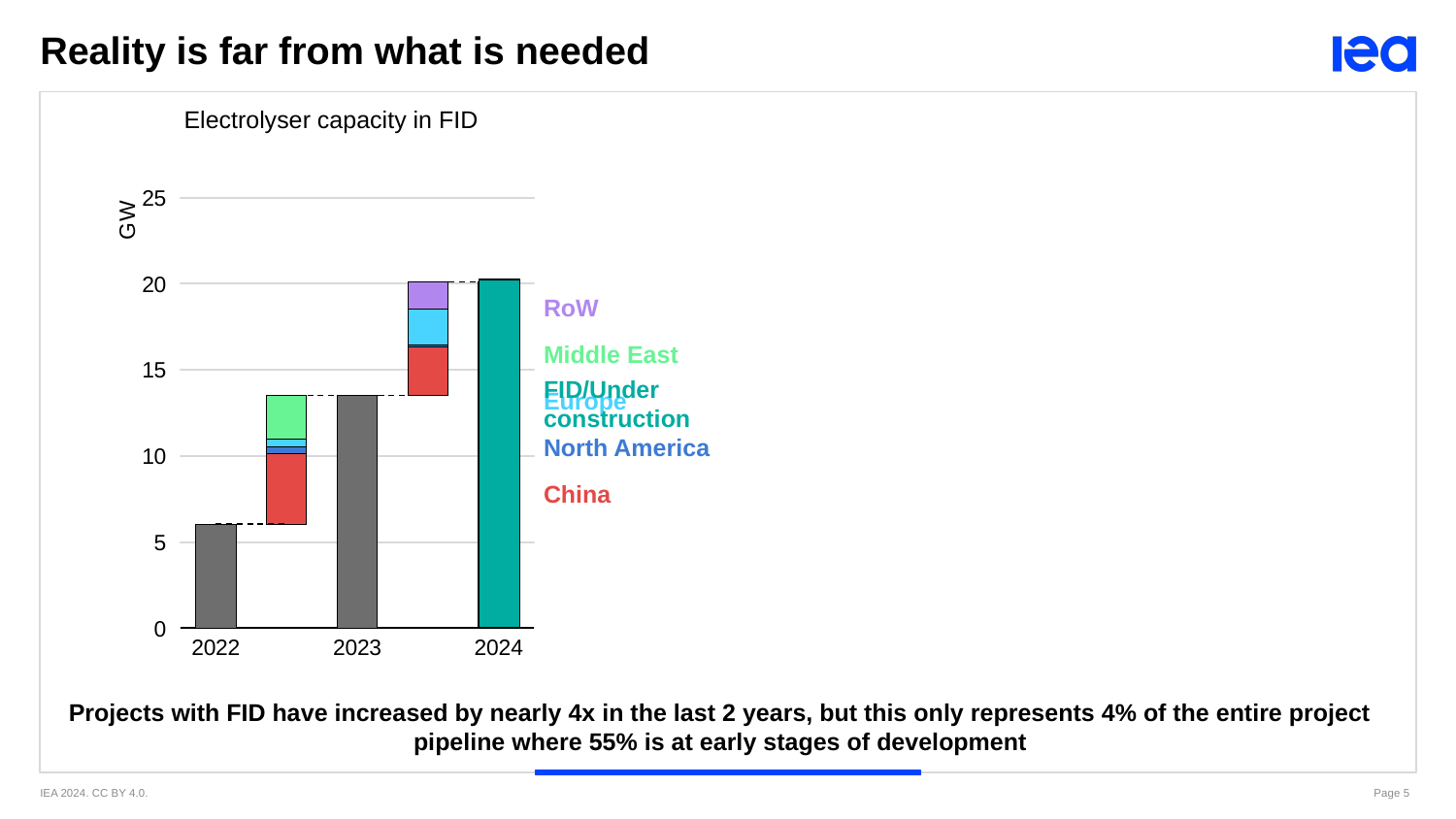
Which year has the highest electrolyser capacity in FID? 2024 How many years are shown on the x axis of the chart? 3 Which is larger, the value for 2022 or the value for 2024? 2024 What type of chart is shown on the slide? bar chart Is the value for 2023 greater or less than 10? greater Does electrolyser capacity in FID rise or fall from 2022 to 2024? rise Which year has the lowest electrolyser capacity in FID? 2022 Is the value for 2022 greater or less than 10? less Is the value for 2024 greater or less than 15? greater What is the title of the chart? Electrolyser capacity in FID What unit is shown on the y axis of the chart? GW